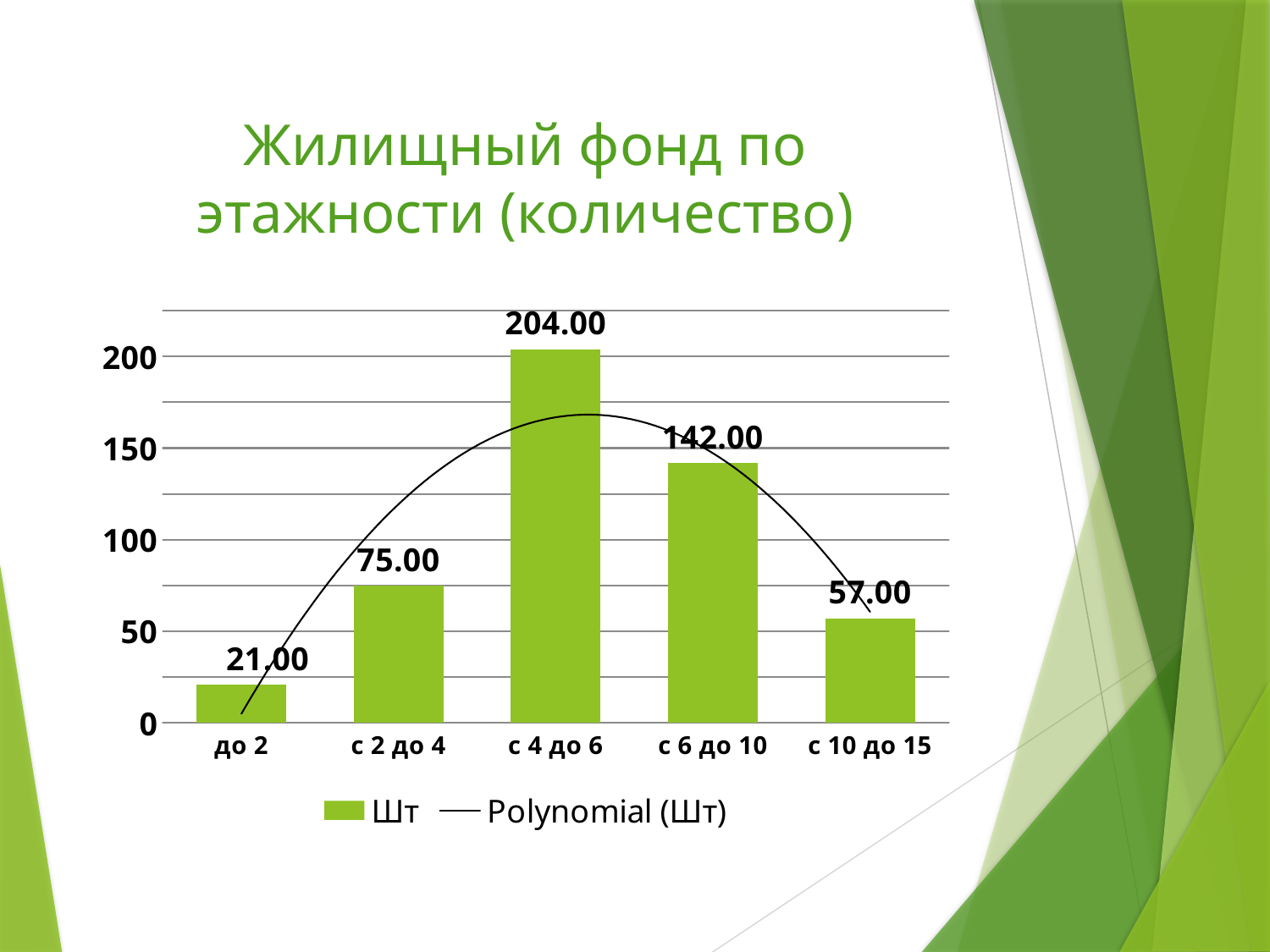
What is the value for the category "с 10 до 15"? 57.00 Which is larger, the value for "с 2 до 4" or the value for "с 10 до 15"? с 2 до 4 What is the difference between the values for "с 4 до 6" and "с 6 до 10"? 62.00 What is the value for the category "с 4 до 6"? 204.00 Which category has the lowest value? до 2 How many entries does the legend list? 2 What is the value for the category "до 2"? 21.00 Which category has the highest value? с 4 до 6 What is the title of the chart? Жилищный фонд по этажности (количество) What kind of chart is shown on the slide? bar chart How many categories are shown on the x axis? 5 Is the value for "с 6 до 10" greater or less than 100? greater